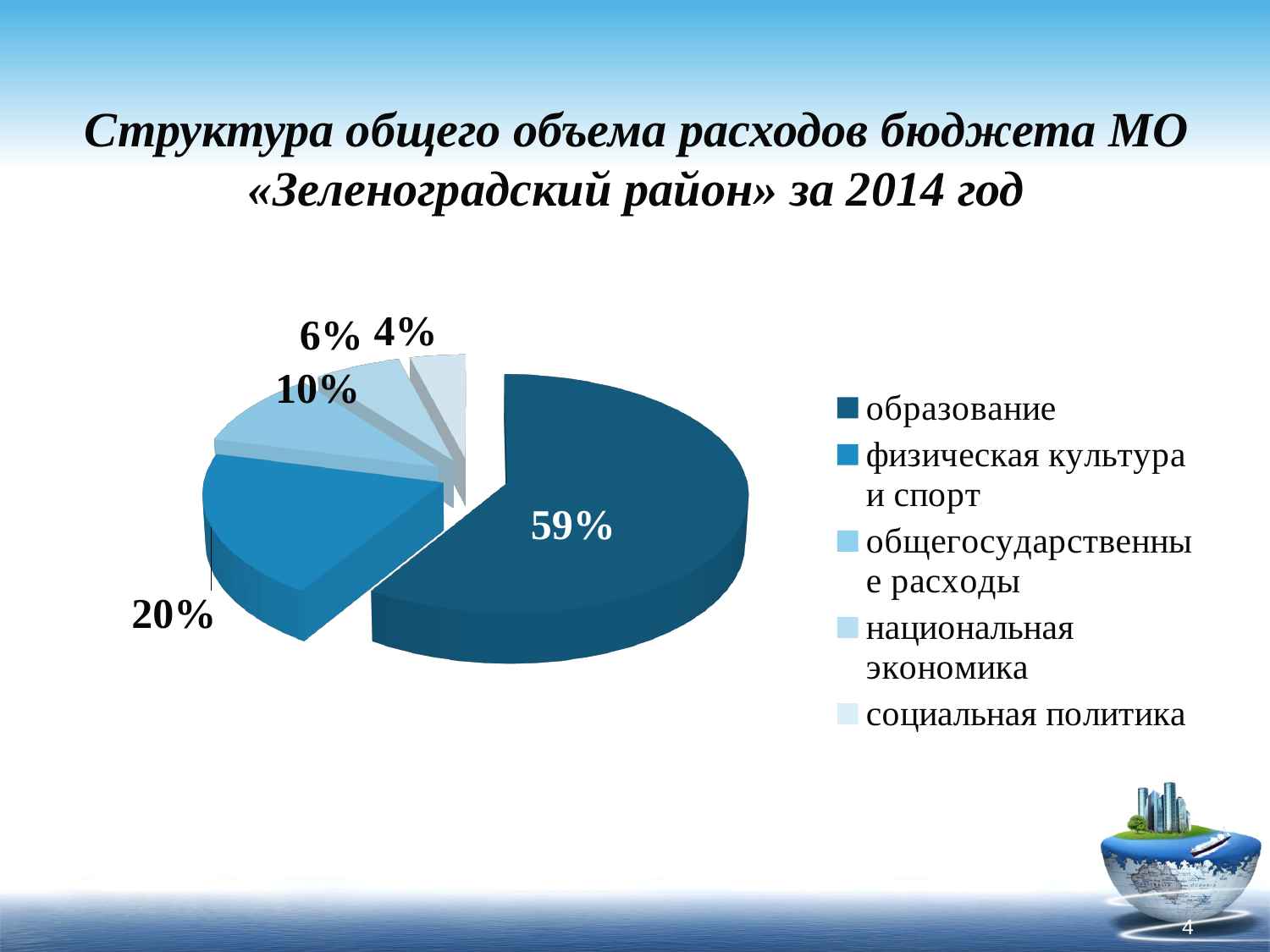
Which category has the smallest share of the budget expenditure? социальная политика Which year does the chart title say the budget expenditure structure refers to? 2014 Which category has the largest share of the budget expenditure? образование How many slices does the pie chart have? 5 What share of the budget expenditure goes to социальная политика? 4% What share of the budget expenditure goes to образование? 59% What share of the budget expenditure goes to общегосударственные расходы? 10% What share of the budget expenditure goes to национальная экономика? 6% What kind of chart is shown on the slide? pie chart How many percentage points larger is the share for образование than the share for физическая культура и спорт? 39 Which is larger: the share for общегосударственные расходы or the share for национальная экономика? общегосударственные расходы What share of the budget expenditure goes to физическая культура и спорт? 20%